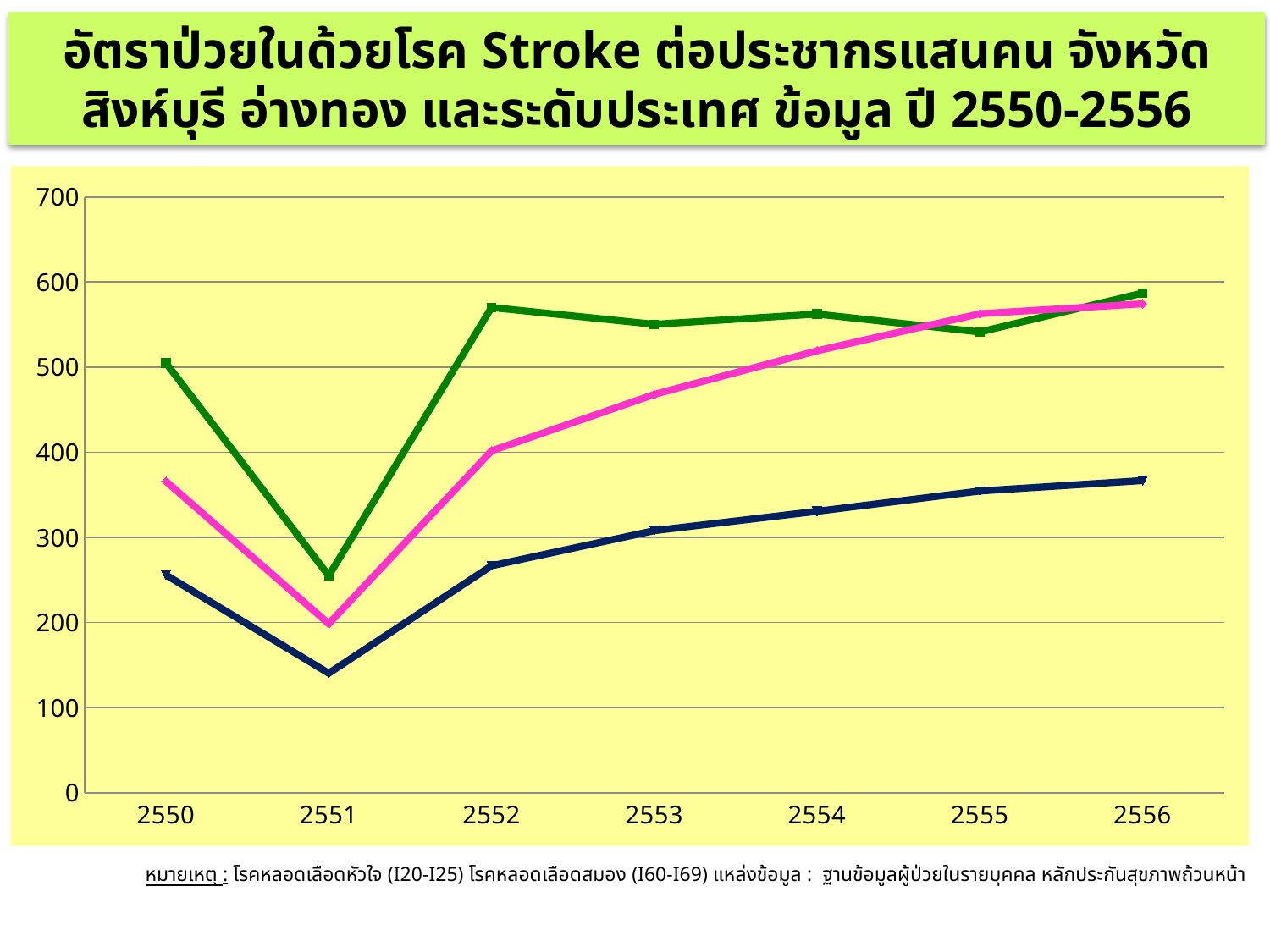
In which year is the pink line at its lowest? 2551 Is the value of the pink line in 2553 greater or less than 400? greater In which year is the green line at its lowest? 2551 How many years are shown along the x axis of the chart? 7 Is the value of the dark blue line in 2556 greater or less than 400? less In 2552, which is higher: the green line or the dark blue line? the green line Does the dark blue line rise or fall from 2551 to 2556? rises What is the highest value shown on the y axis of the chart? 700 Is the value of the dark blue line in 2551 greater or less than 200? less In which year is the dark blue line at its lowest? 2551 What kind of chart is shown on the slide? line chart